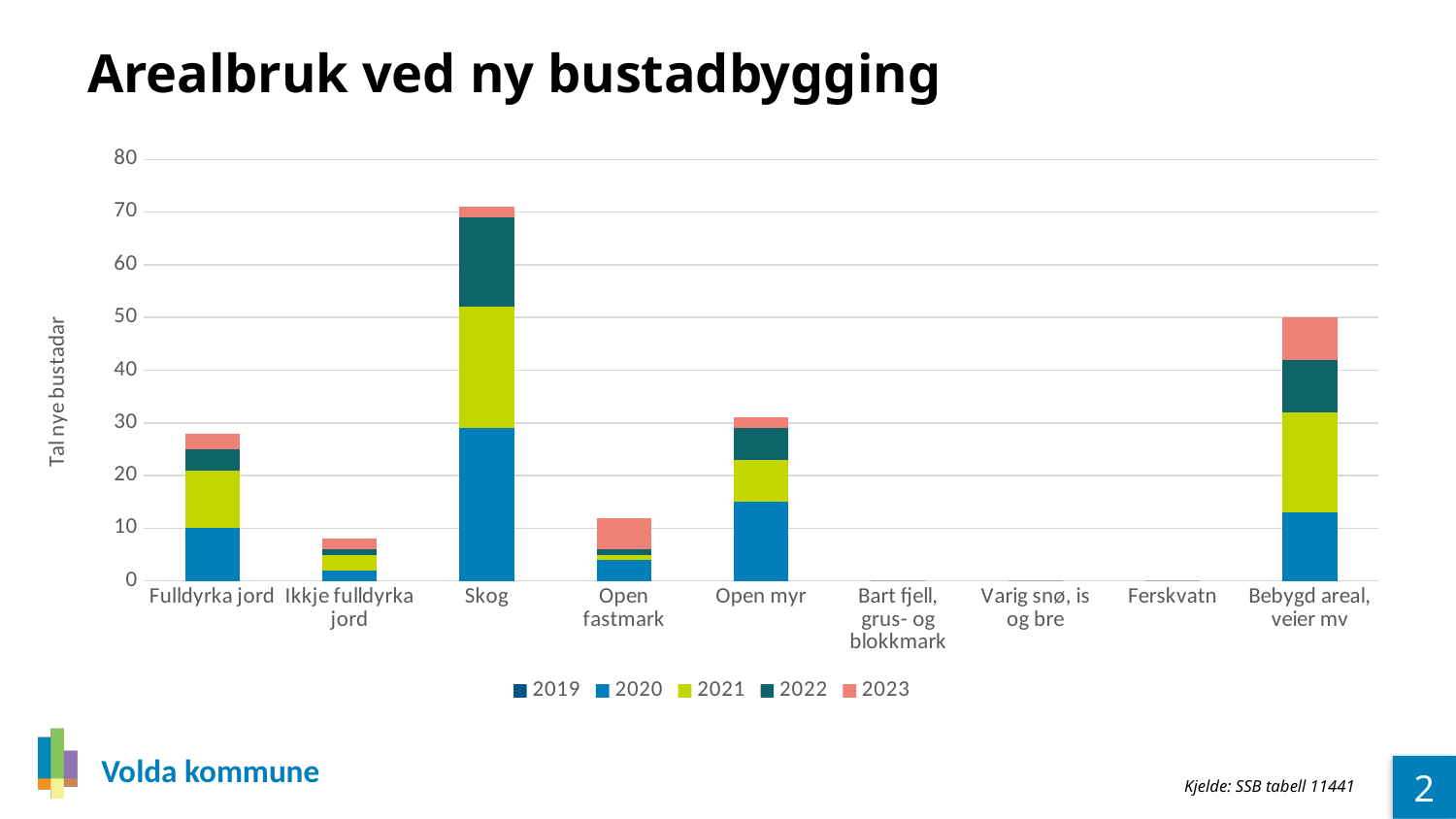
What type of chart is shown on the slide? Stacked bar chart Is the total stacked value for Skog greater or less than 60? greater Which has the larger total stacked bar, Skog or Bebygd areal, veier mv? Skog How many categories are shown on the x axis of the chart? 9 Which category has the tallest stacked bar? Skog Is the total stacked value for Fulldyrka jord greater or less than 20? greater Is the total stacked value for Open fastmark greater or less than 20? less How many series does the legend list? 5 What is the title of the chart on the slide? Arealbruk ved ny bustadbygging Which has the larger total stacked bar, Open myr or Open fastmark? Open myr